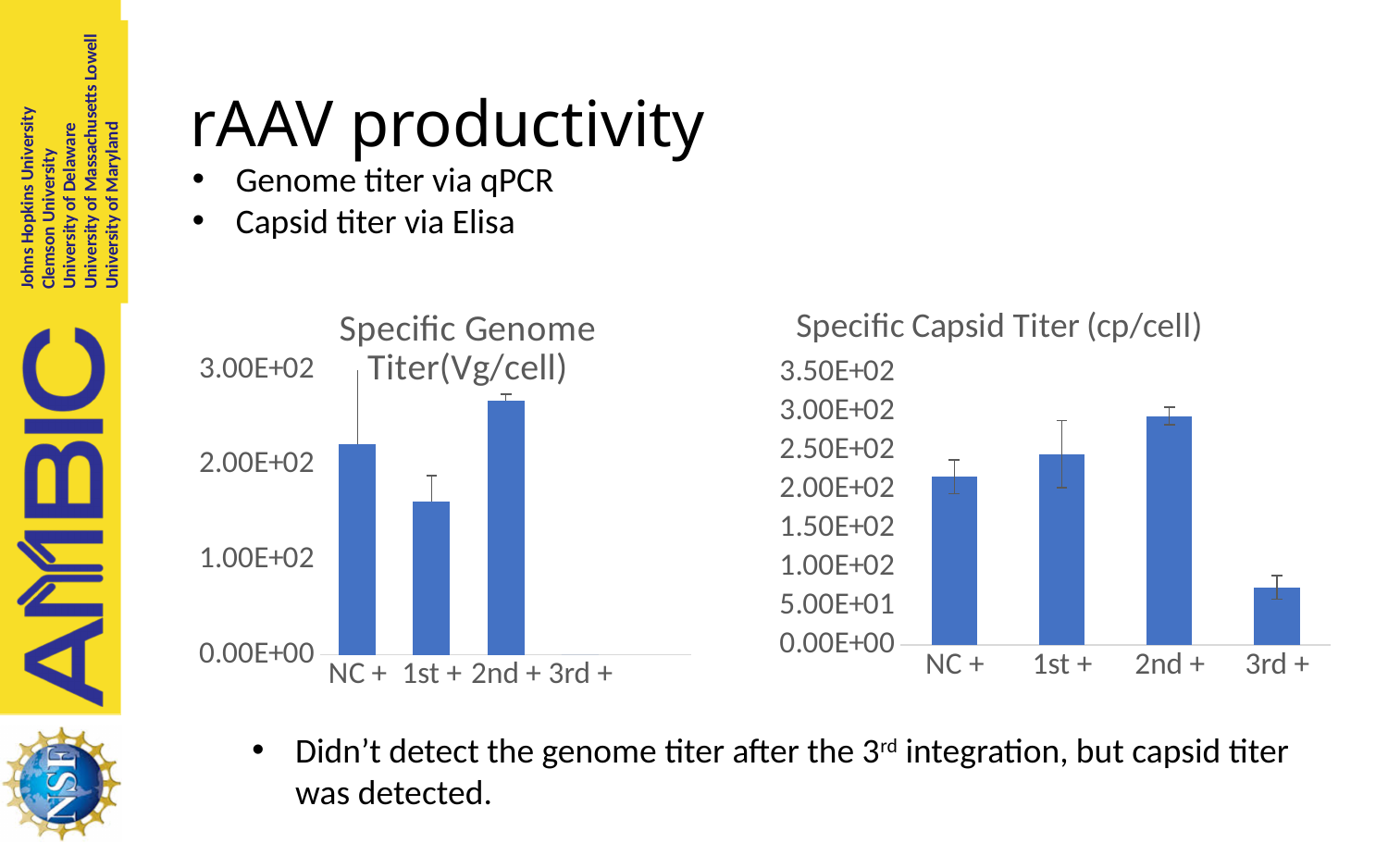
In the Specific Genome Titer(Vg/cell) chart, is the value for 1st + greater or less than 2.00E+02? less In the Specific Capsid Titer (cp/cell) chart, which is larger, the value for 2nd + or the value for 3rd +? 2nd + In the Specific Genome Titer(Vg/cell) chart, is the value for 2nd + greater or less than 2.00E+02? greater In the Specific Capsid Titer (cp/cell) chart, is the value for 3rd + greater or less than 1.00E+02? less What kind of chart is the Specific Genome Titer(Vg/cell) chart? bar chart How many categories are shown on the x axis of the Specific Capsid Titer (cp/cell) chart? 4 In the Specific Genome Titer(Vg/cell) chart, which category has the highest value? 2nd + What is the title of the chart on the right side of the slide? Specific Capsid Titer (cp/cell) In the Specific Genome Titer(Vg/cell) chart, which category has the lowest value? 3rd + In the Specific Capsid Titer (cp/cell) chart, which category has the lowest value? 3rd + In the Specific Capsid Titer (cp/cell) chart, which category has the highest value? 2nd +